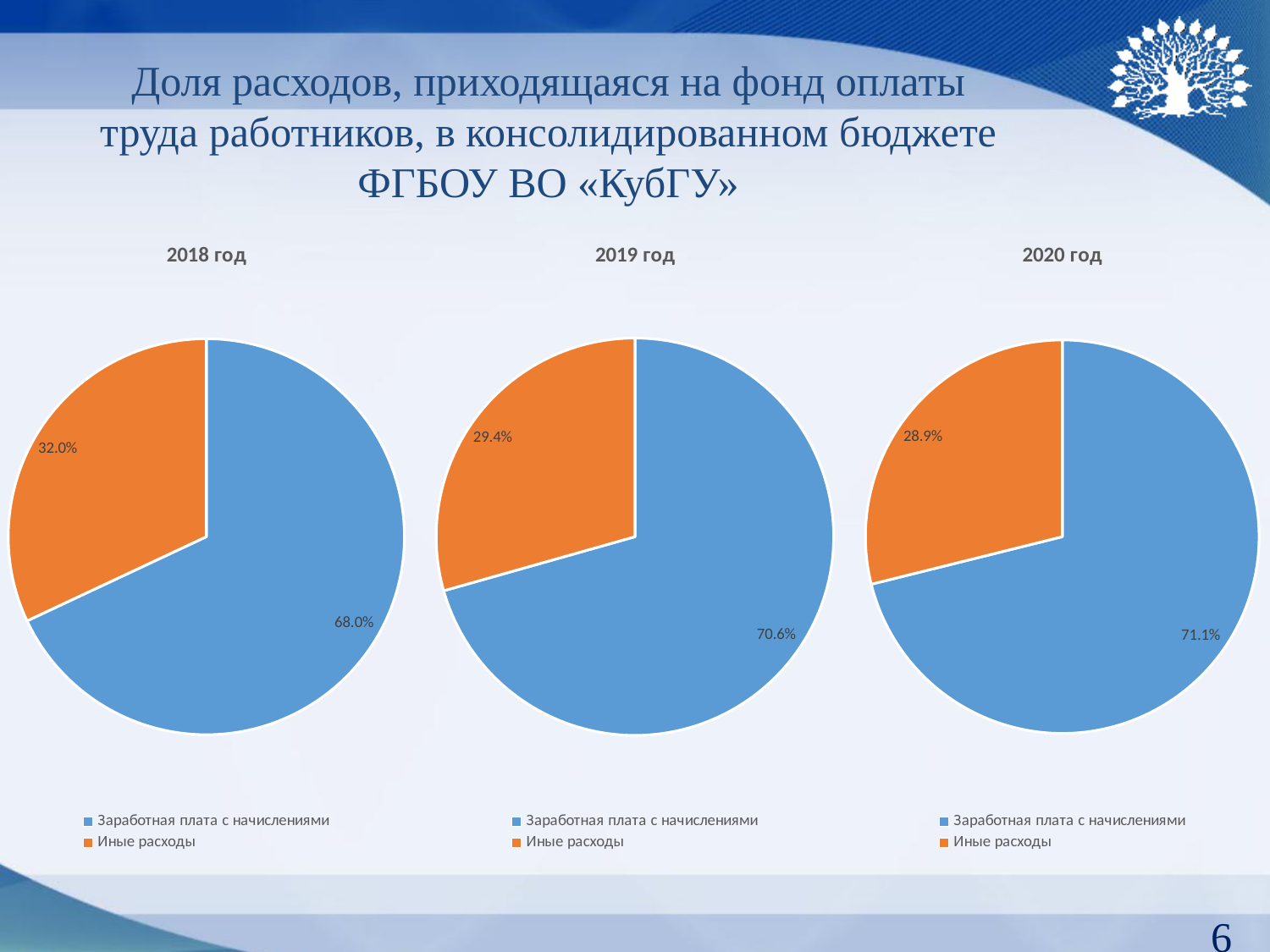
Which is larger: the "Иные расходы" share in the "2018 год" chart or in the "2020 год" chart? 2018 год What colour represents "Иные расходы" in the pie charts? Orange How many entries does the legend of the "2020 год" chart list? 2 In the "2018 год" chart, what share is labelled for "Иные расходы"? 32.0% What kind of chart is the "2019 год" chart? Pie chart How many slices does the "2019 год" pie chart have? 2 In the "2018 год" chart, which slice is the smallest? Иные расходы In the "2020 год" chart, which slice is the largest? Заработная плата с начислениями In the "2018 год" chart, what share is labelled for "Заработная плата с начислениями"? 68.0% In the "2020 год" chart, what share is labelled for "Заработная плата с начислениями"? 71.1% What is the difference between the "Заработная плата с начислениями" share in the "2020 год" chart and in the "2018 год" chart? 3.1% In the "2019 год" chart, what share is labelled for "Иные расходы"? 29.4%